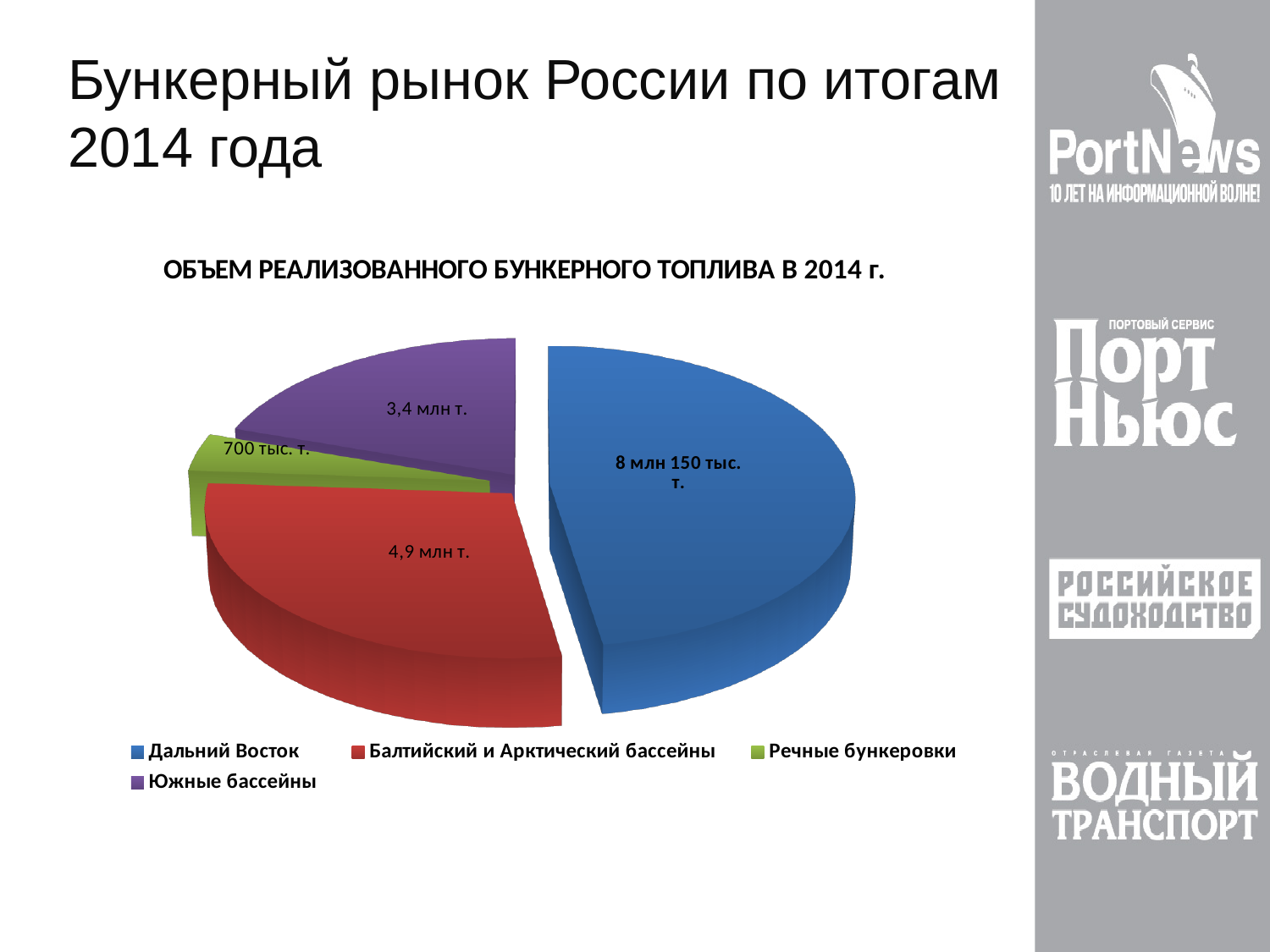
What is the value shown for Южные бассейны? 3,4 млн т. Which category has the smallest slice of the pie? Речные бункеровки Which is larger: Балтийский и Арктический бассейны or Южные бассейны? Балтийский и Арктический бассейны What is the title of the chart? ОБЪЕМ РЕАЛИЗОВАННОГО БУНКЕРНОГО ТОПЛИВА В 2014 г. What is the value shown for Речные бункеровки? 700 тыс. т. How many entries does the legend list? 4 How many slices does the pie chart have? 4 What is the value shown for Балтийский и Арктический бассейны? 4,9 млн т. What is the value shown for Дальний Восток? 8 млн 150 тыс. т. What is the difference between the values for Балтийский и Арктический бассейны and Южные бассейны? 1,5 млн т. Which category has the largest slice of the pie? Дальний Восток What kind of chart is shown on the slide? Pie chart